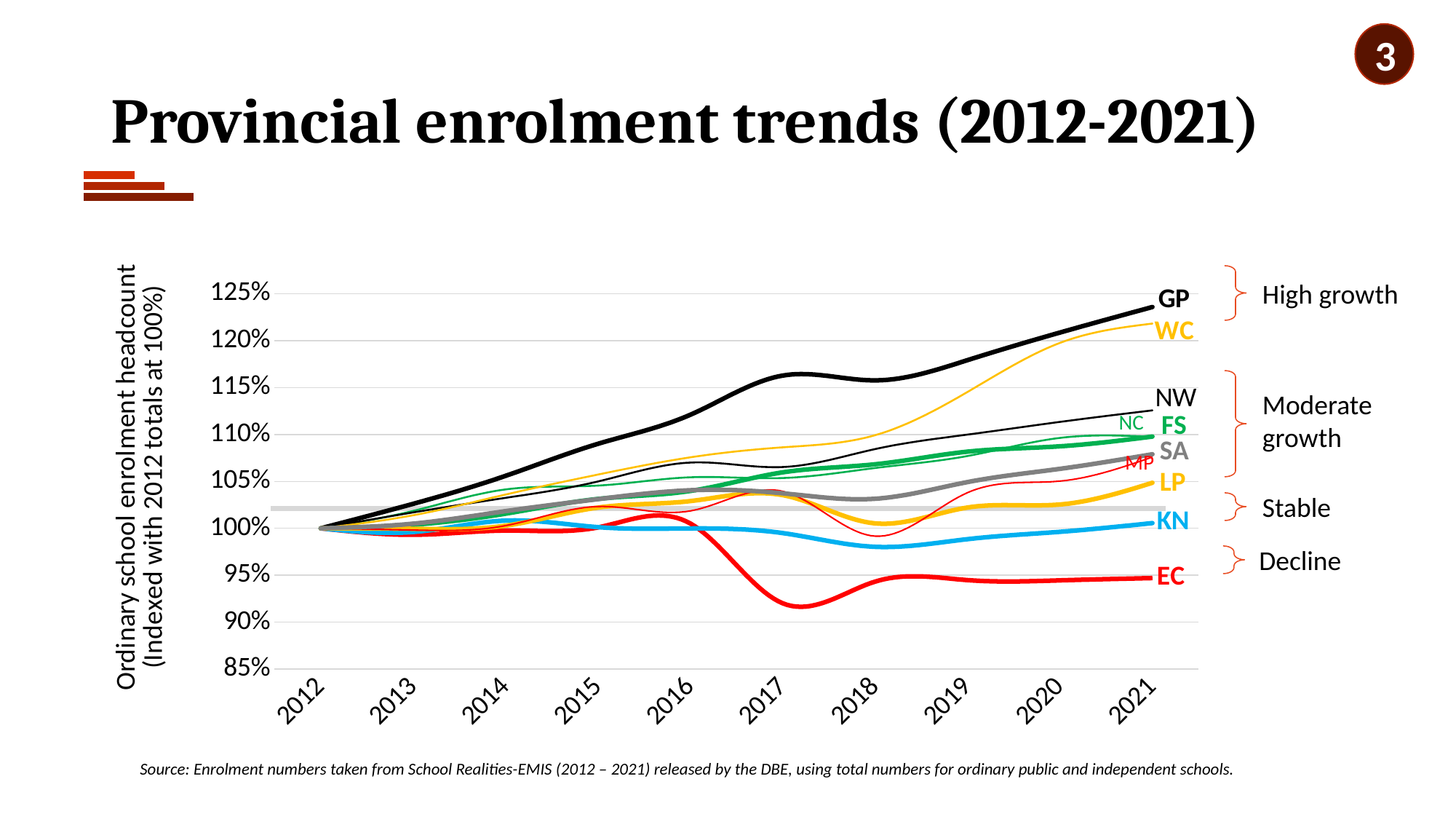
Is the value for EC in 2021 greater or less than 100%? less How many years are shown on the x axis of the chart? 10 Is the value for NW in 2021 greater or less than 110%? greater Is the value for GP in 2021 greater or less than 120%? greater What kind of chart is shown on the slide? line chart What is the indexed value for all provinces in 2012? 100% Which province has the highest indexed enrolment in 2021? GP Which two provinces are grouped under the 'High growth' label? GP and WC Does the GP line rise or fall from 2012 to 2021? rise Which is larger in 2021, the value for WC or the value for KN? WC Which province has the lowest indexed enrolment in 2021? EC